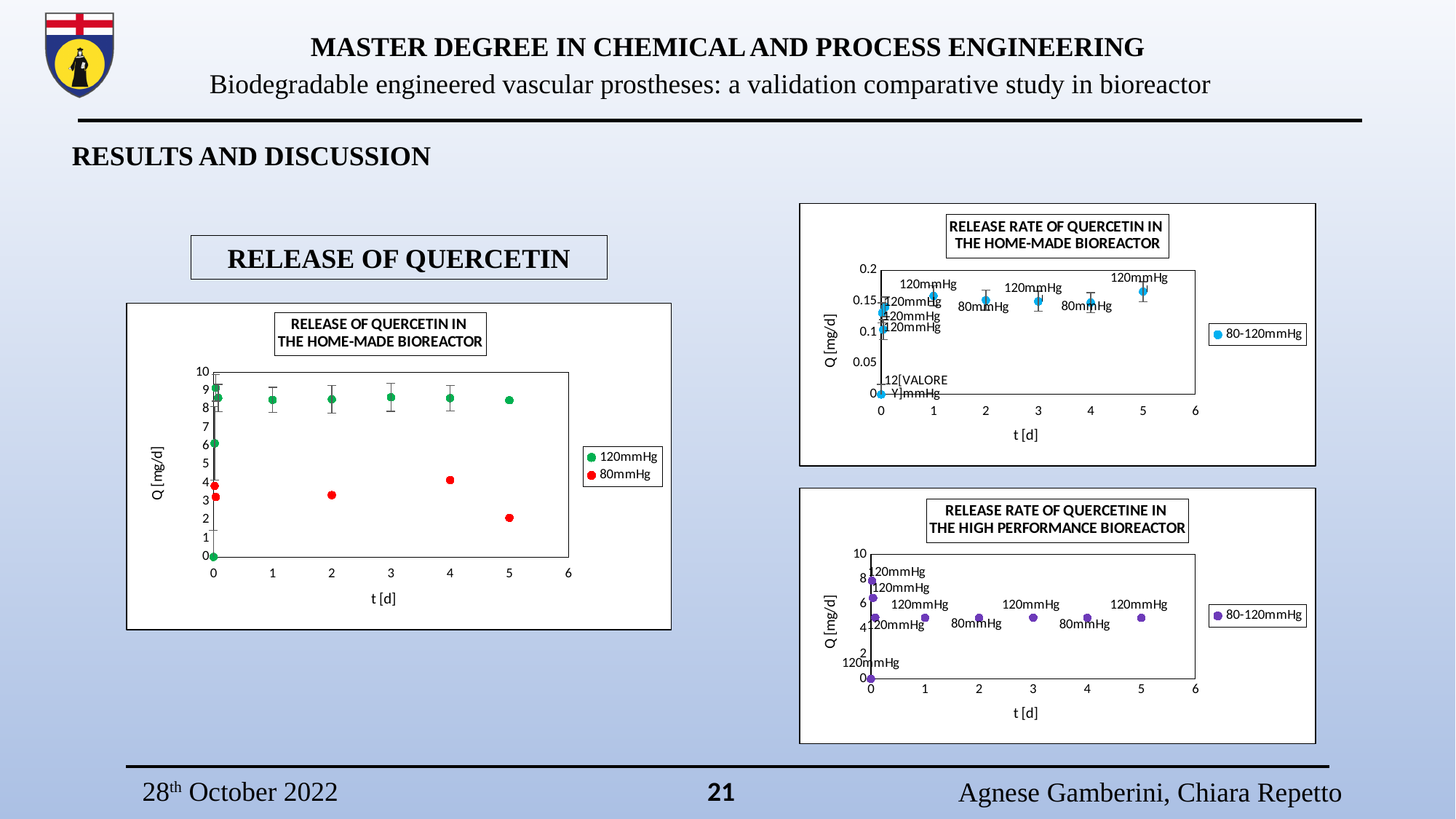
In the chart titled 'RELEASE OF QUERCETIN IN THE HOME-MADE BIOREACTOR', is the 80mmHg value at t = 5 d greater or less than 3 mg/d? less In the chart titled 'RELEASE RATE OF QUERCETIN IN THE HOME-MADE BIOREACTOR', is the value at t = 5 d greater or less than 0.1? greater In the chart titled 'RELEASE RATE OF QUERCETINE IN THE HIGH PERFORMANCE BIOREACTOR', is the value at t = 3 d greater or less than 6? less In the chart titled 'RELEASE OF QUERCETIN IN THE HOME-MADE BIOREACTOR', which series has the higher values at t = 5 d, 120mmHg or 80mmHg? 120mmHg In the chart titled 'RELEASE RATE OF QUERCETINE IN THE HIGH PERFORMANCE BIOREACTOR', do the values from t = 1 d to t = 5 d rise, fall, or stay roughly flat? Stay roughly flat What kind of chart is 'RELEASE RATE OF QUERCETIN IN THE HOME-MADE BIOREACTOR'? Scatter chart In the chart titled 'RELEASE RATE OF QUERCETINE IN THE HIGH PERFORMANCE BIOREACTOR', what is the legend entry? 80-120mmHg In the chart titled 'RELEASE OF QUERCETIN IN THE HOME-MADE BIOREACTOR', what are the two legend entries? 120mmHg and 80mmHg In the chart titled 'RELEASE OF QUERCETIN IN THE HOME-MADE BIOREACTOR', what is the label of the y axis? Q [mg/d] In the chart titled 'RELEASE RATE OF QUERCETIN IN THE HOME-MADE BIOREACTOR', how many series does the legend list? 1 In the chart titled 'RELEASE OF QUERCETIN IN THE HOME-MADE BIOREACTOR', how many series does the legend list? 2